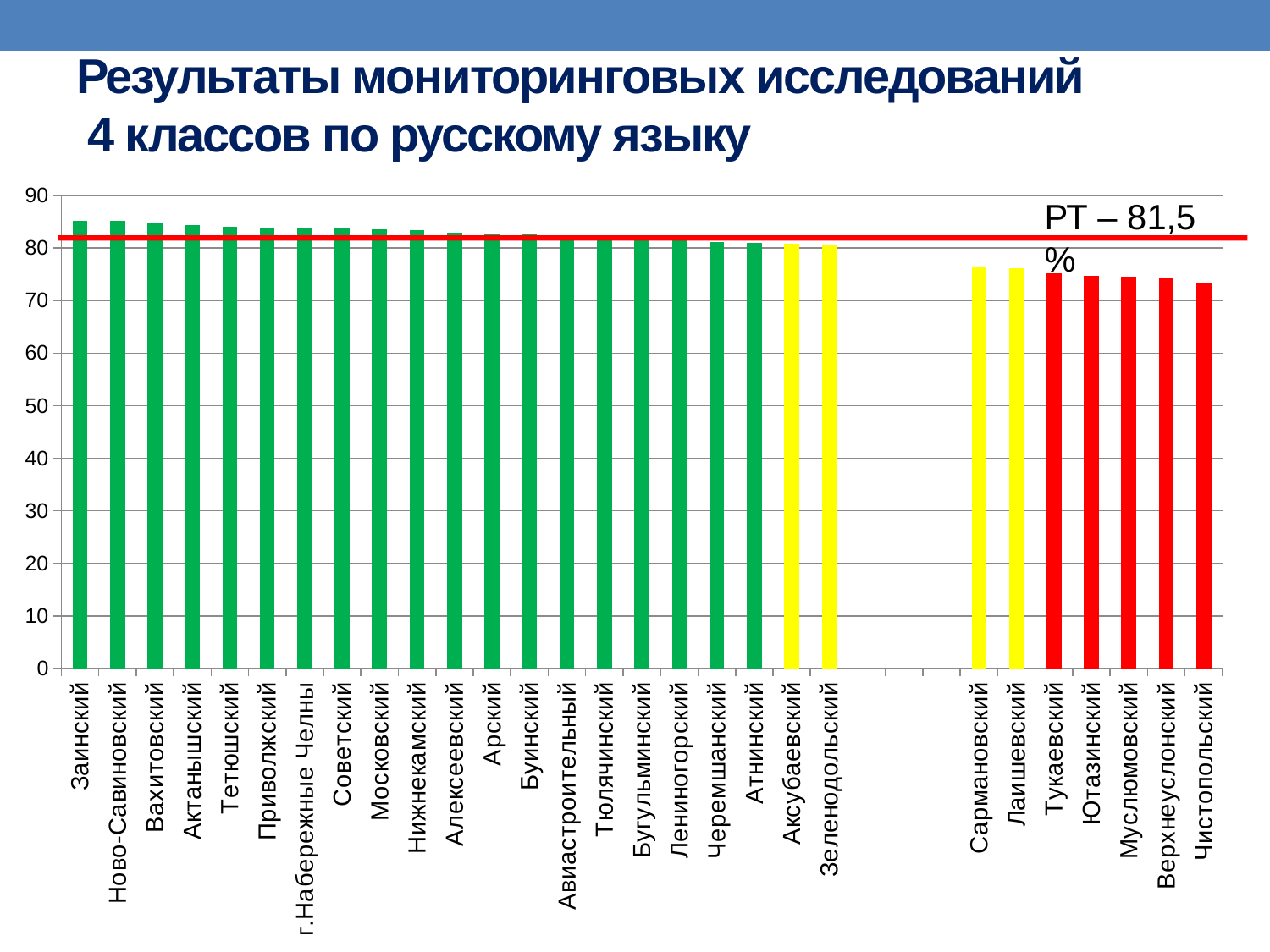
Is the value for Чистопольский greater or less than 80? less Is the value for Тукаевский greater or less than 70? greater How many bars are coloured red? 5 What kind of chart is shown on the slide? bar chart Is the value for Заинский greater or less than 80? greater Which has the larger value, Заинский or Чистопольский? Заинский Which has the larger value, Лаишевский or Буинский? Буинский What value does the red horizontal reference line represent, according to its label? РТ – 81,5 % Do the bar values generally rise or fall from left to right along the x axis? fall What is the title of the slide's chart? Результаты мониторинговых исследований 4 классов по русскому языку